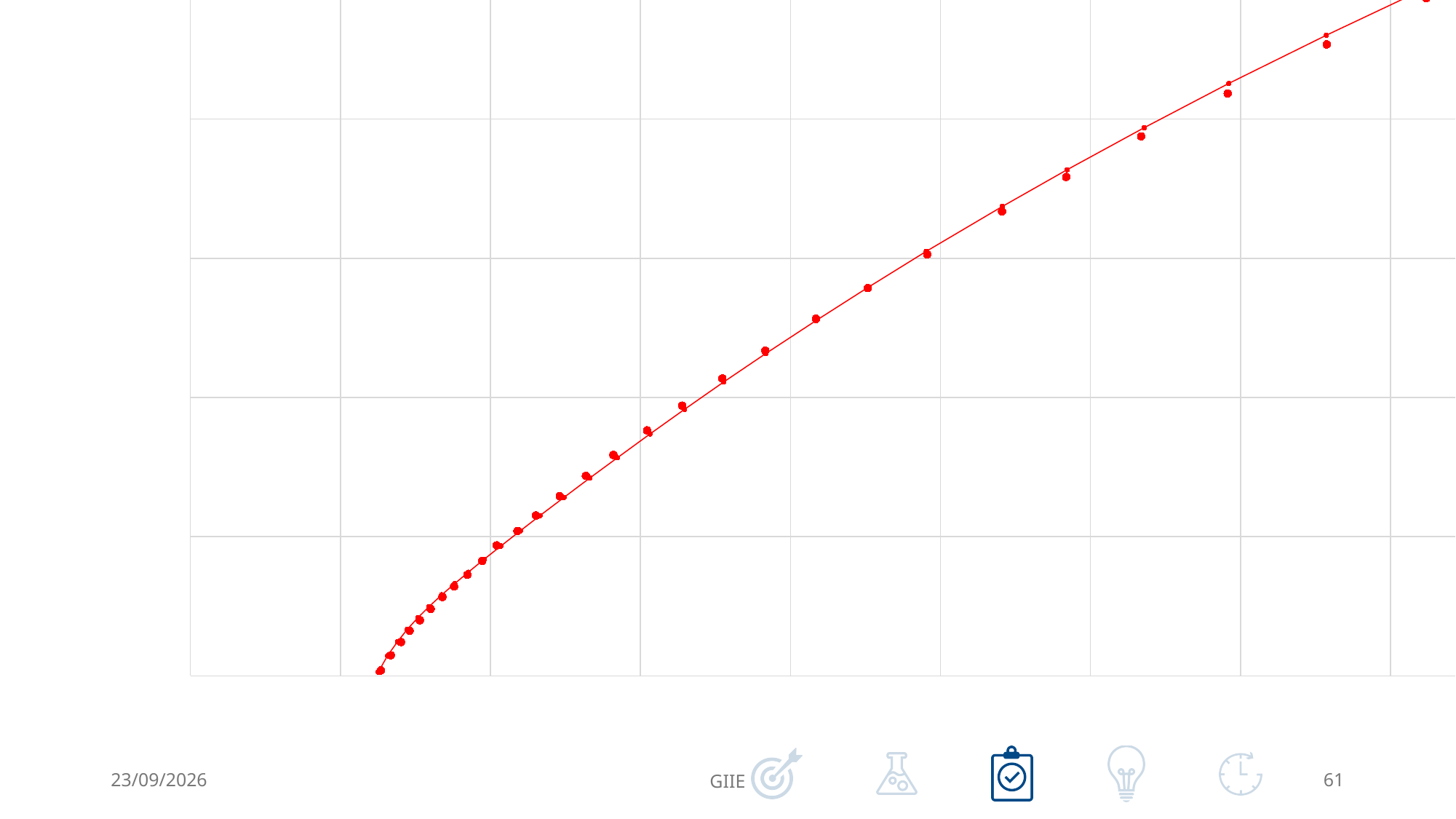
What kind of chart is shown on the slide? scatter chart with a fitted line What colour are the data points and the line on the chart? red Do the plotted values rise or fall as you move from left to right along the x axis? rise Does the chart display a legend? no